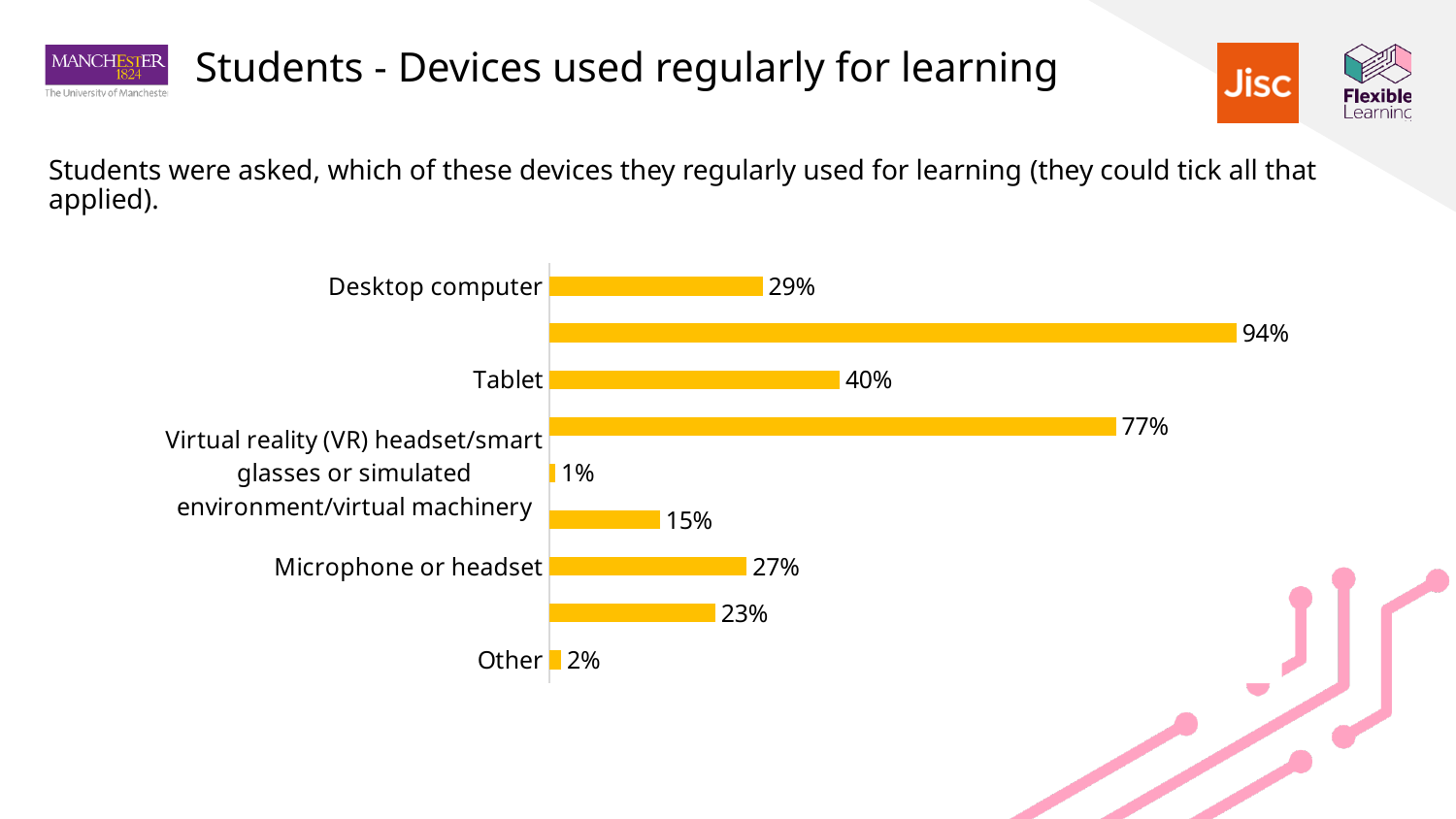
What percentage of students regularly use a microphone or headset for learning? 27% What percentage of students regularly use a desktop computer for learning? 29% What percentage of students regularly use a tablet for learning? 40% What is the highest percentage value shown on the chart? 94% Which is larger, the percentage for Tablet or for Desktop computer? Tablet What type of chart is shown on the slide? Bar chart What percentage of students selected 'Other'? 2% Which is larger, the percentage for Desktop computer or for Microphone or headset? Desktop computer What is the difference in percentage points between Tablet and Desktop computer? 11% Which device category has the lowest percentage in the chart? Virtual reality (VR) headset/smart glasses or simulated environment/virtual machinery What percentage of students regularly use a virtual reality (VR) headset/smart glasses or simulated environment/virtual machinery for learning? 1% How many bars are plotted in the chart? 9